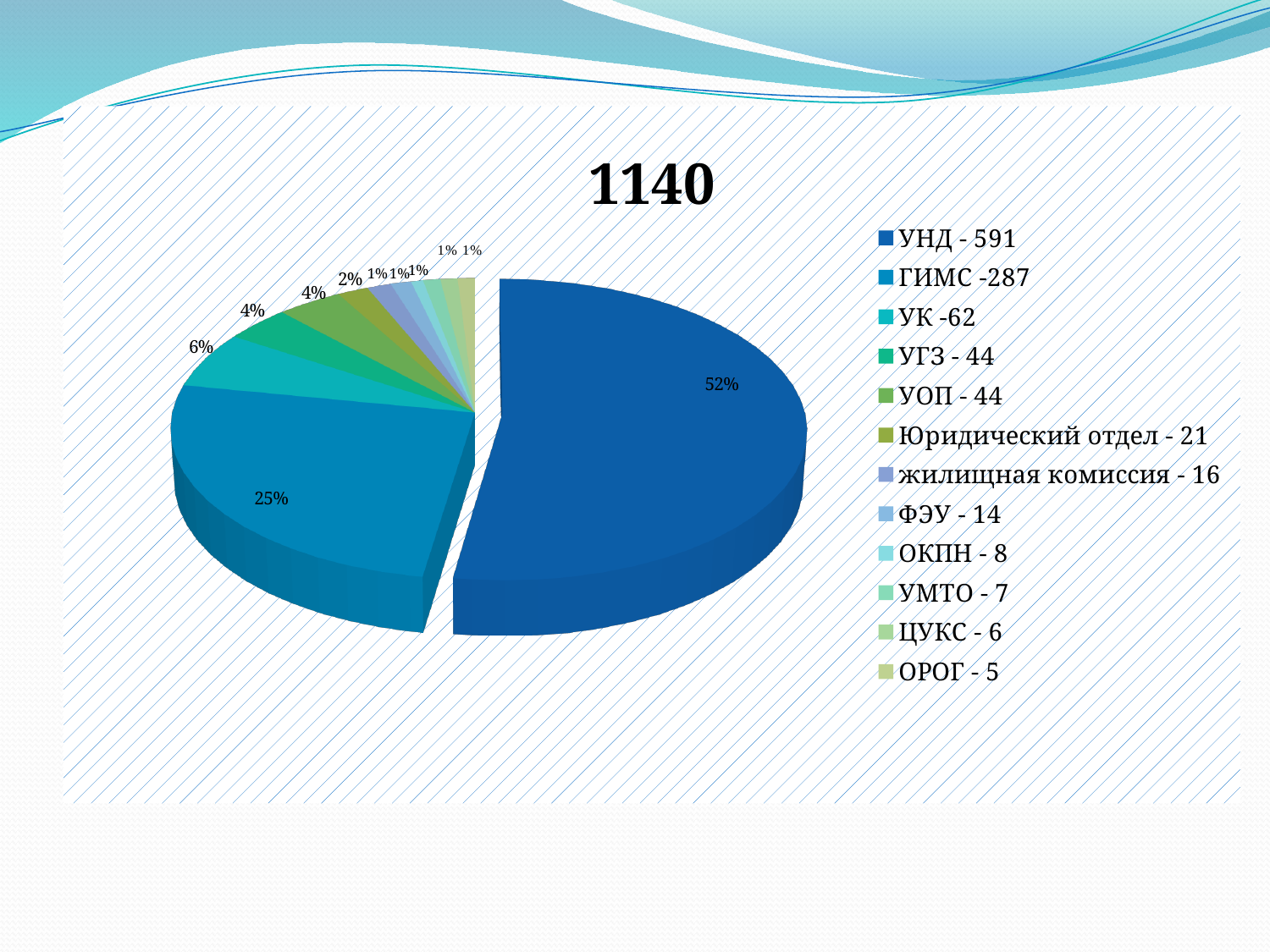
What share of the pie does ГИМС take? 25% Which category has the smallest value in the legend? ОРОГ Which category has the largest slice of the pie? УНД What value is shown for ГИМС in the legend? 287 How many entries does the legend list? 12 Which is larger, the value for УК or the value for УГЗ? УК What kind of chart is shown on the slide? pie chart What value is shown for УНД in the legend? 591 What value is shown for Юридический отдел in the legend? 21 What is the title of the chart? 1140 What share of the pie does УНД take? 52% What is the difference between the values for УНД and ГИМС? 304